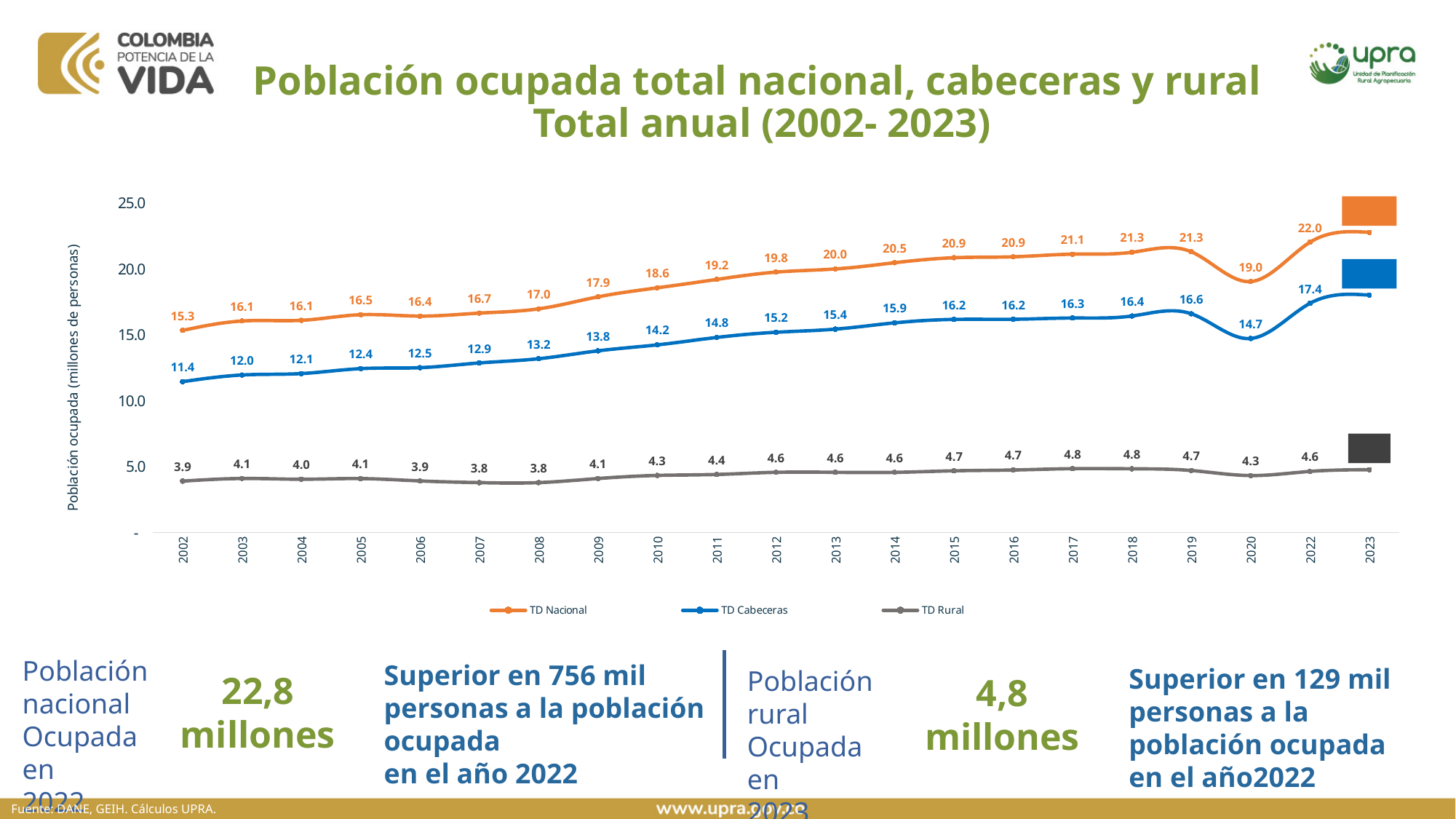
What is the value of TD Rural in 2010? 4.3 Which is larger, TD Nacional in 2019 or TD Nacional in 2020? TD Nacional in 2019 What kind of chart is shown on the slide? Line chart What is the difference between TD Nacional in 2022 and in 2020? 3.0 What is the value of TD Cabeceras in 2020? 14.7 How many series does the legend list? 3 Is the value for TD Cabeceras in 2023 greater or less than 15.0? greater How many years are shown on the x axis? 21 What is the value of TD Nacional in 2002? 15.3 In which year is TD Cabeceras at its lowest? 2002 What is the difference between TD Cabeceras and TD Rural in 2018? 11.6 What is the value of TD Nacional in 2022? 22.0